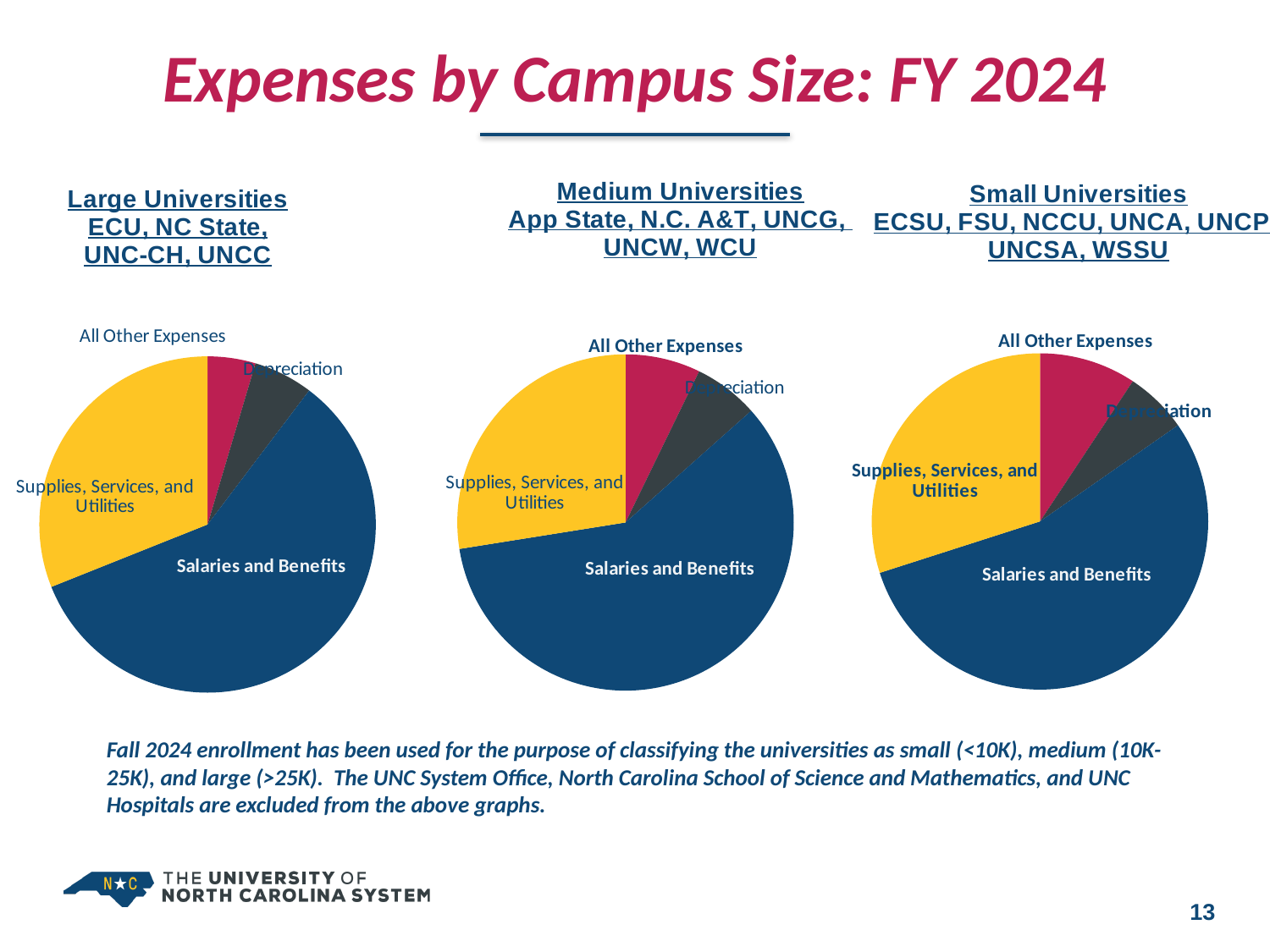
Which universities are listed under the Medium Universities pie chart? App State, N.C. A&T, UNCG, UNCW, WCU What kind of chart is used for the Large Universities expenses? Pie chart In the Large Universities pie chart, which expense category has the largest slice? Salaries and Benefits In the Medium Universities pie chart, which is larger: Salaries and Benefits or Supplies, Services, and Utilities? Salaries and Benefits How many expense categories are shown in the Large Universities pie chart? 4 How many pie charts are shown on the slide? 3 In the Small Universities pie chart, which expense category has the largest slice? Salaries and Benefits In the Large Universities pie chart, which is larger: Supplies, Services, and Utilities or All Other Expenses? Supplies, Services, and Utilities In the Small Universities pie chart, which is larger: Supplies, Services, and Utilities or Depreciation? Supplies, Services, and Utilities In the Medium Universities pie chart, which expense category has the largest slice? Salaries and Benefits How many expense categories are shown in the Small Universities pie chart? 4